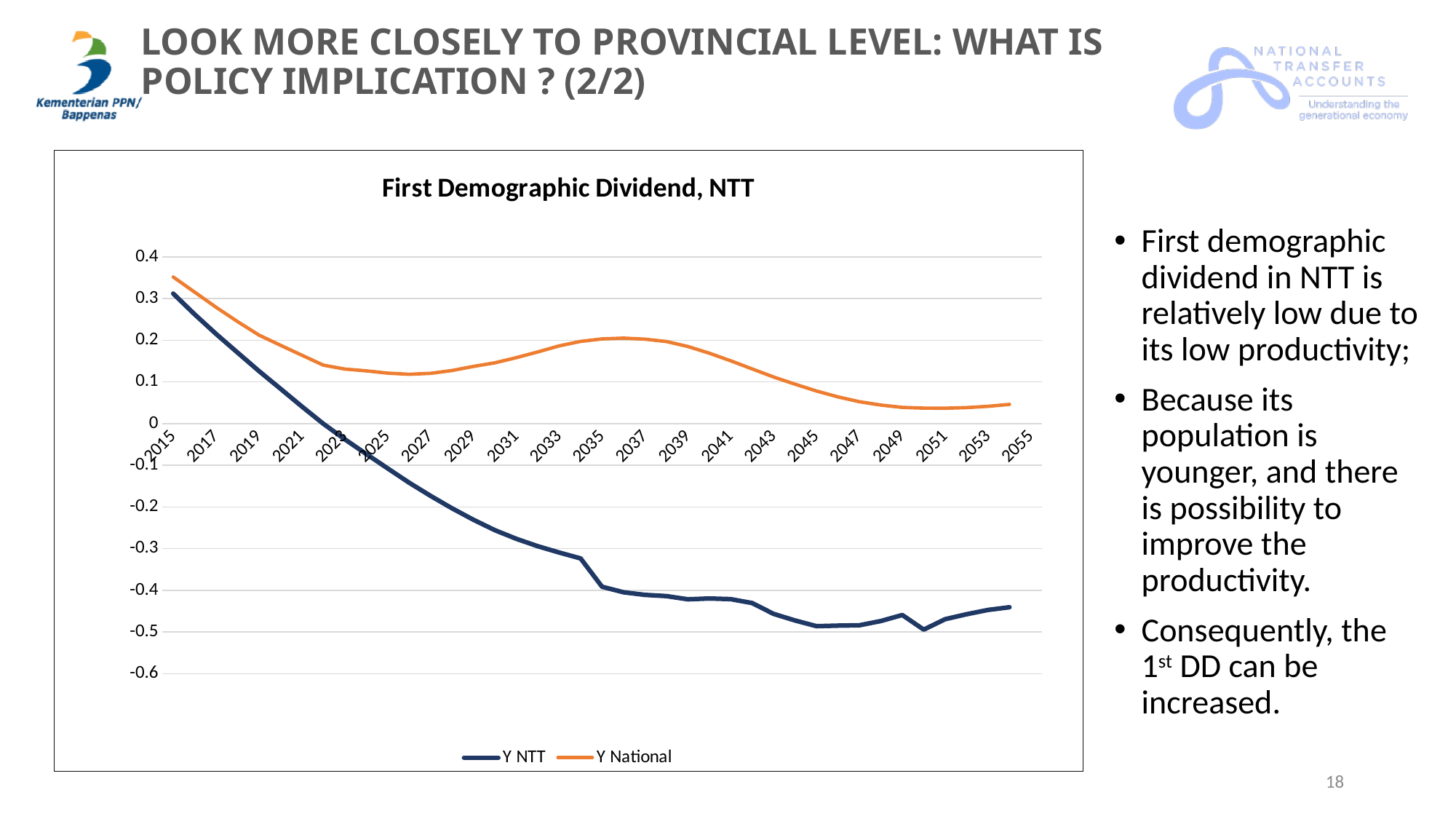
Which series is drawn in orange? Y National Is the value of Y NTT in 2045 greater or less than -0.4? less Is the value of Y National in 2015 greater or less than 0.3? greater What kind of chart is shown on the slide? line chart Is the value of Y National in 2051 greater or less than 0.1? less In 2025, which series has the higher value, Y NTT or Y National? Y National Does the Y National line rise or fall between 2027 and 2037? rise Does the Y NTT line rise or fall between 2015 and 2045? fall How many series does the legend list? 2 What is the title of the chart? First Demographic Dividend, NTT